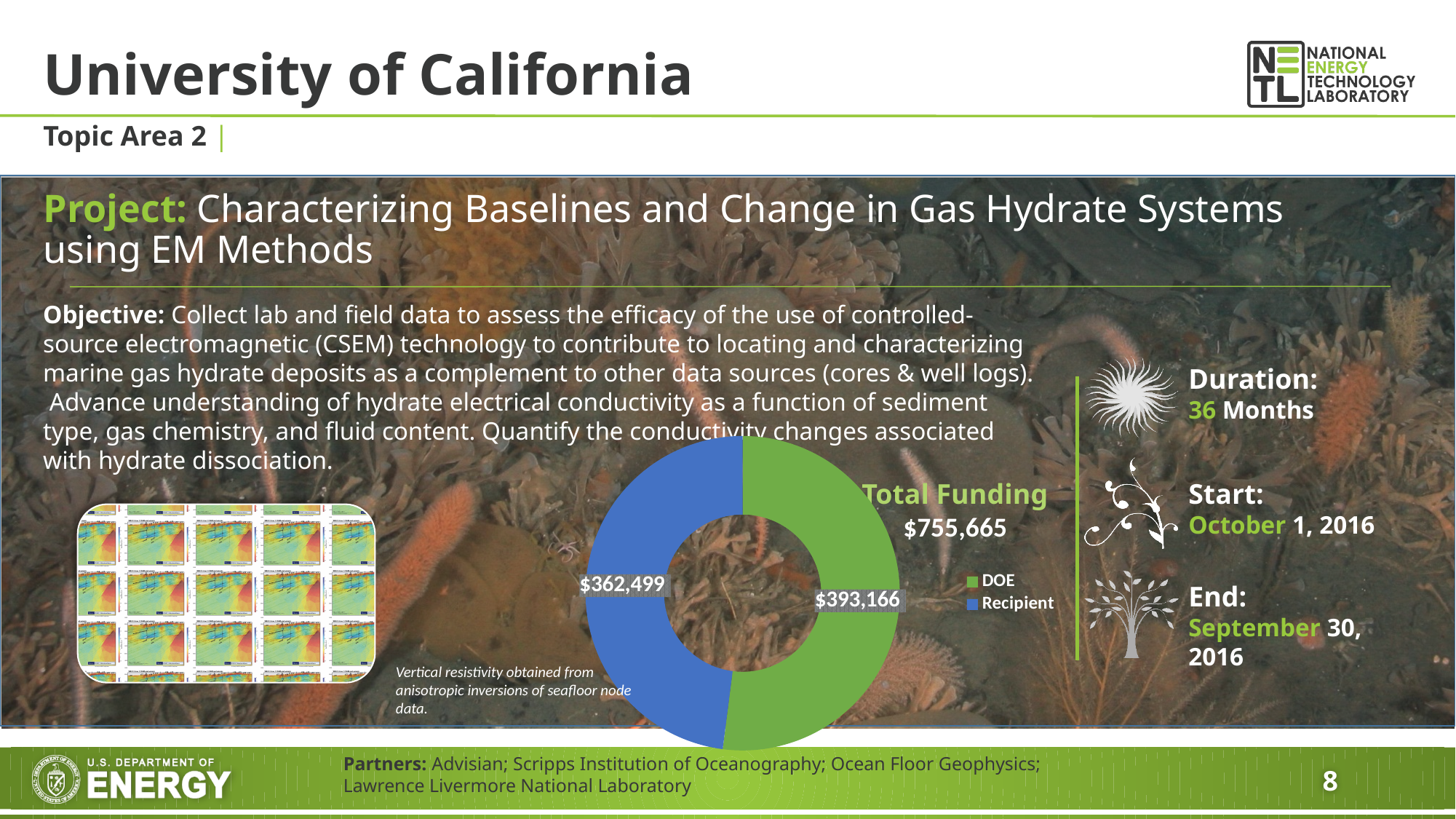
Which category has the largest slice in the chart? DOE Which category has the smallest slice in the chart? Recipient How many categories does the chart's legend list? 2 What is the total funding shown next to the chart? $755,665 What colour represents Recipient in the chart? Blue What type of chart is shown on the slide? Pie chart (donut) Which funding source has the larger slice, DOE or Recipient? DOE What is the Recipient funding amount shown in the chart? $362,499 What colour represents DOE in the chart? Green What is the DOE funding amount shown in the chart? $393,166 What is the difference between the DOE and Recipient funding amounts? $30,667